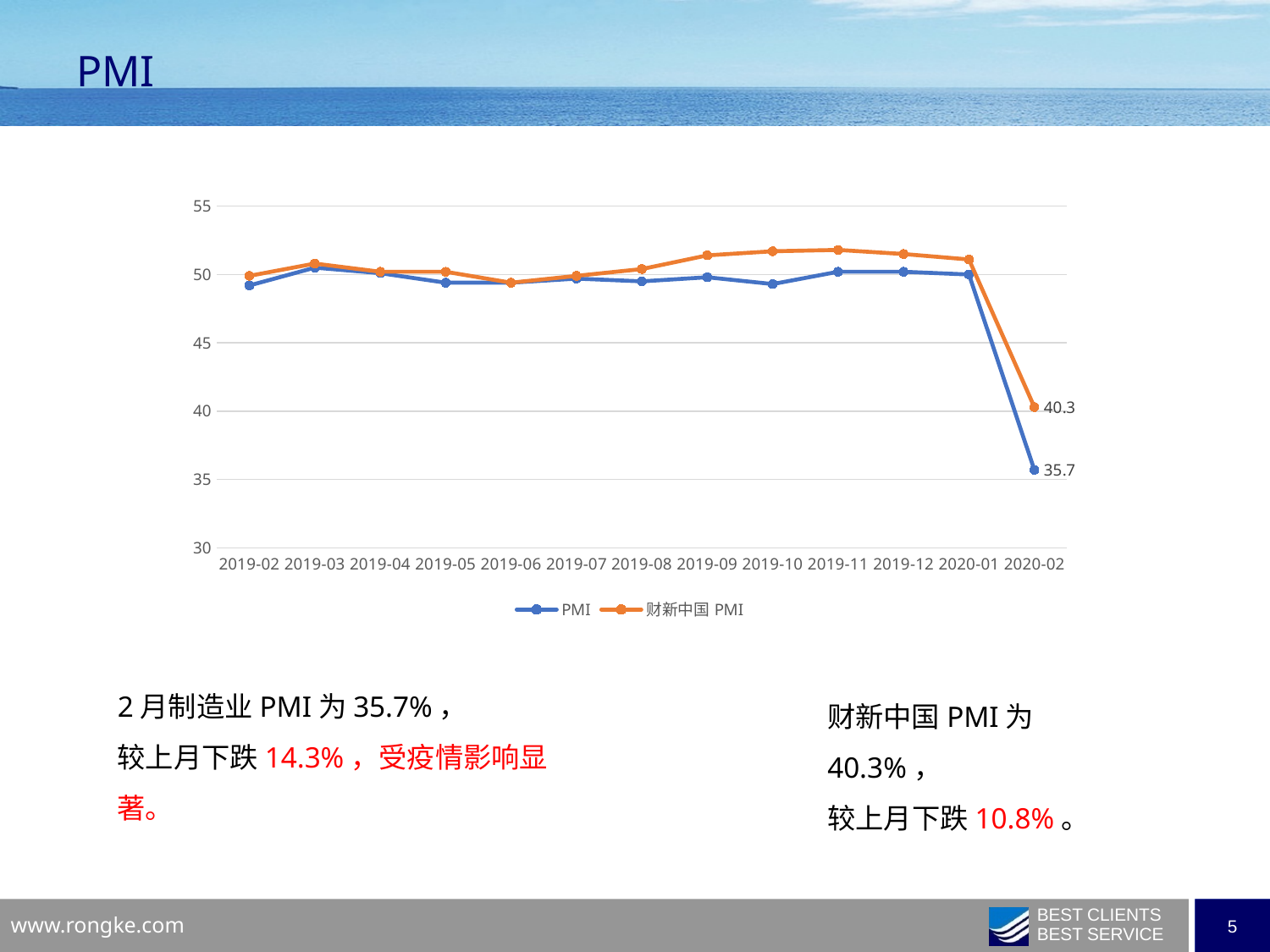
How many series does the legend list? 2 What are the two entries in the chart legend? PMI and 财新中国 PMI What is the value of the 财新中国 PMI series for 2020-02? 40.3 At which month does the PMI series reach its lowest value? 2020-02 Is the value for the PMI series in 2019-02 greater or less than 45? greater Do both series rise or fall between 2020-01 and 2020-02? Fall What kind of chart is shown on the slide? Line chart For 2020-02, which series has the higher value, PMI or 财新中国 PMI? 财新中国 PMI What is the difference between the 财新中国 PMI and the PMI values for 2020-02? 4.6 How many time points are plotted along the x axis? 13 Is the value for the 财新中国 PMI series in 2019-10 greater or less than 50? greater What is the value of the PMI series for 2020-02? 35.7